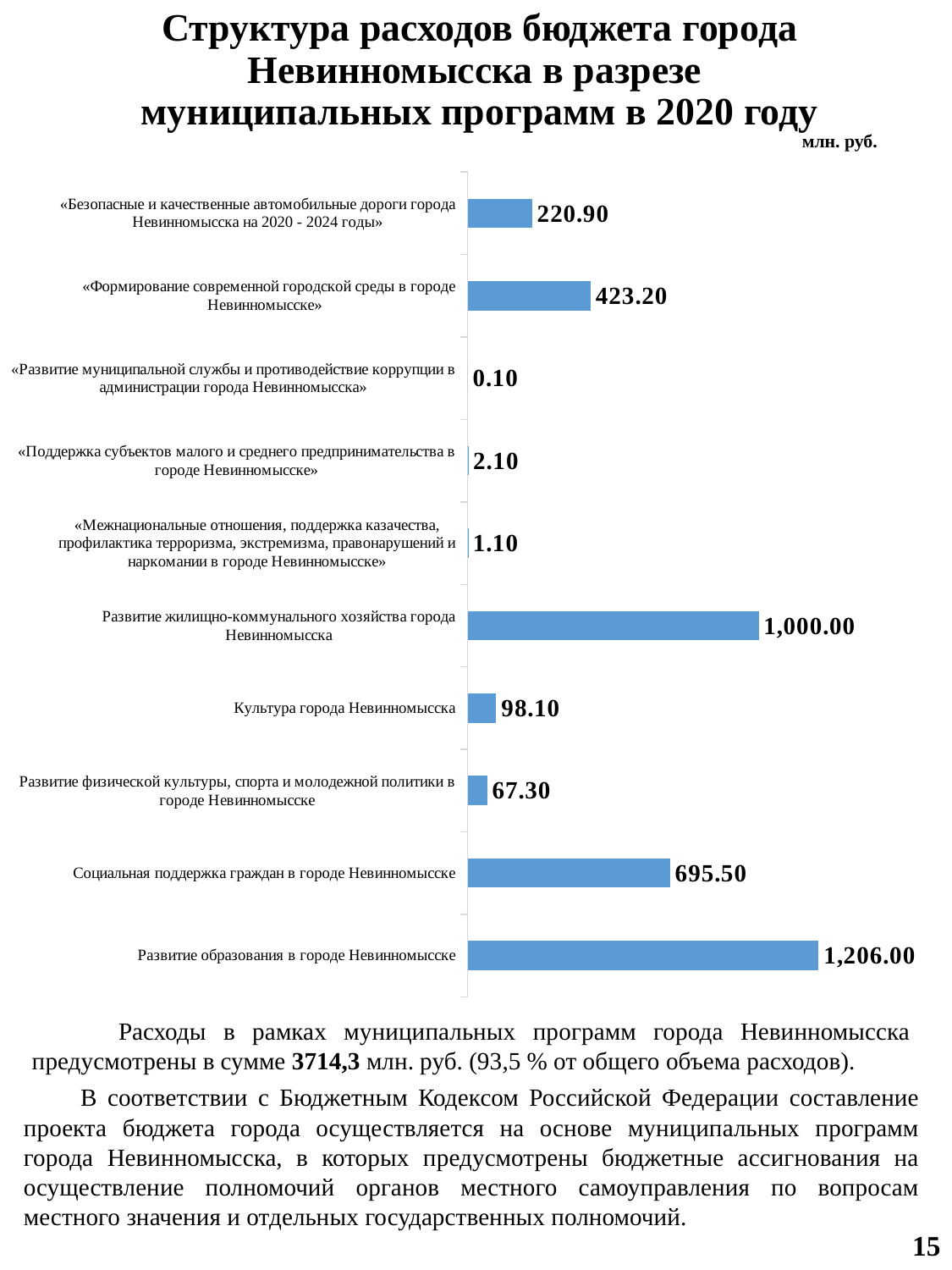
Which program has the lowest value in the chart? «Развитие муниципальной службы и противодействие коррупции в администрации города Невинномысска» Which is larger: the value for «Безопасные и качественные автомобильные дороги города Невинномысска на 2020 - 2024 годы» or for «Культура города Невинномысска»? «Безопасные и качественные автомобильные дороги города Невинномысска на 2020 - 2024 годы» How many municipal programs (categories) are plotted in the chart? 10 What is the value for «Культура города Невинномысска»? 98.10 What kind of chart is shown on the slide? Bar chart In what units are the chart values expressed, according to the label above the chart? млн. руб. What is the difference between the values for «Развитие образования в городе Невинномысске» and «Развитие жилищно-коммунального хозяйства города Невинномысска»? 206.00 What is the value for «Развитие образования в городе Невинномысске»? 1,206.00 What is the difference between the values for «Социальная поддержка граждан в городе Невинномысске» and «Формирование современной городской среды в городе Невинномысске»? 272.30 What is the value for «Формирование современной городской среды в городе Невинномысске»? 423.20 Which program has the highest value in the chart? Развитие образования в городе Невинномысске What is the value for «Социальная поддержка граждан в городе Невинномысске»? 695.50